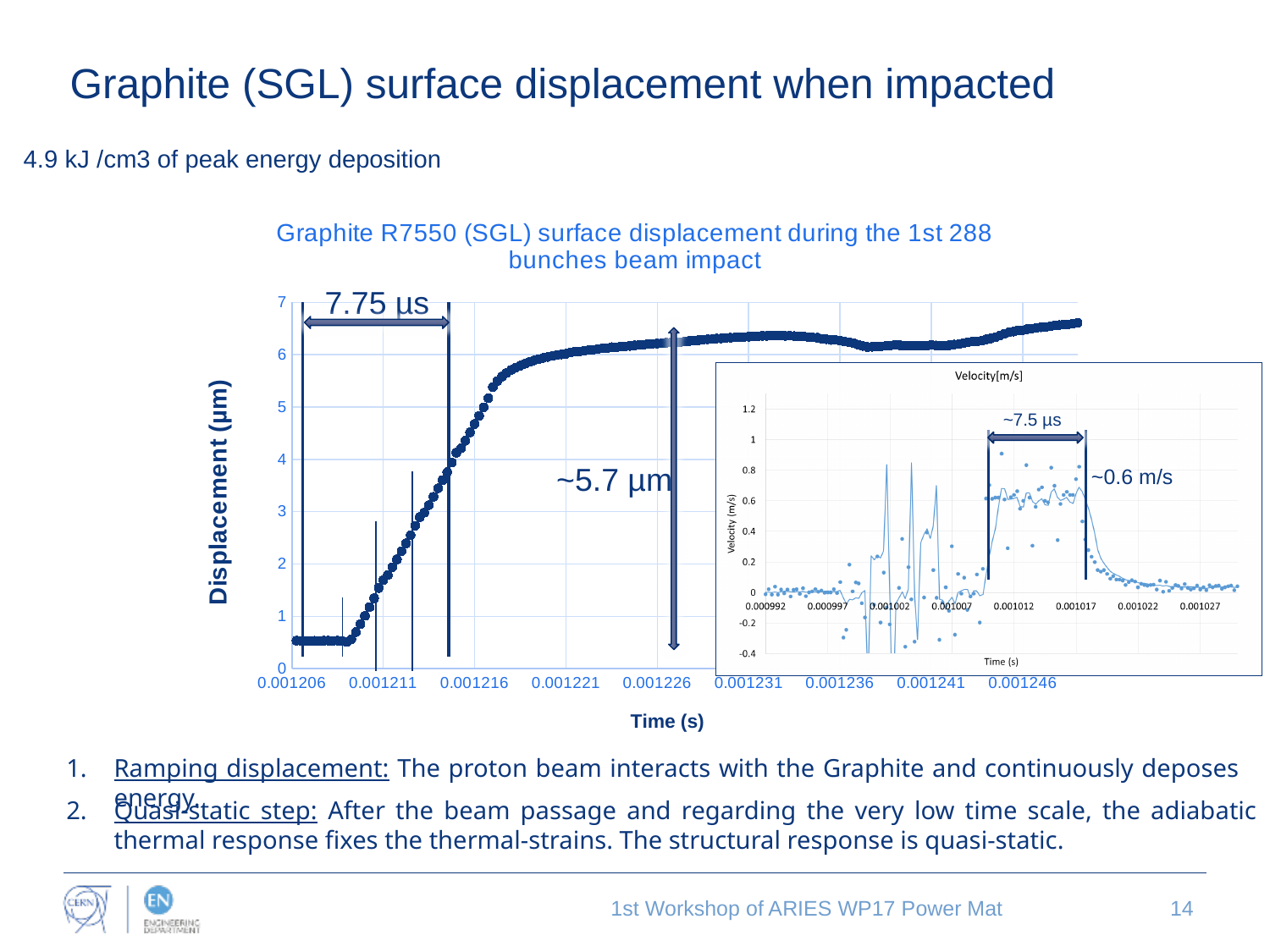
In the inset velocity chart, what velocity level is annotated for the plateau? ~0.6 m/s In the main displacement chart, is the displacement at time 0.001216 greater or less than 3 µm? greater In the main displacement chart, is the displacement at time 0.001206 greater or less than 1 µm? less In the main displacement chart, is the displacement at time 0.001226 greater or less than 6 µm? greater What is the title of the inset chart on the right? Velocity[m/s] In the main displacement chart, does the displacement rise or fall overall along the time axis? rise In the main displacement chart, what duration is annotated for the ramping displacement phase? 7.75 µs What kind of chart is the main chart titled 'Graphite R7550 (SGL) surface displacement during the 1st 288 bunches beam impact'? scatter chart In the inset velocity chart, what duration is annotated for the plateau? ~7.5 µs In the main displacement chart, what displacement step is annotated by the vertical arrow? ~5.7 µm What is the label of the vertical axis of the main displacement chart? Displacement (µm)